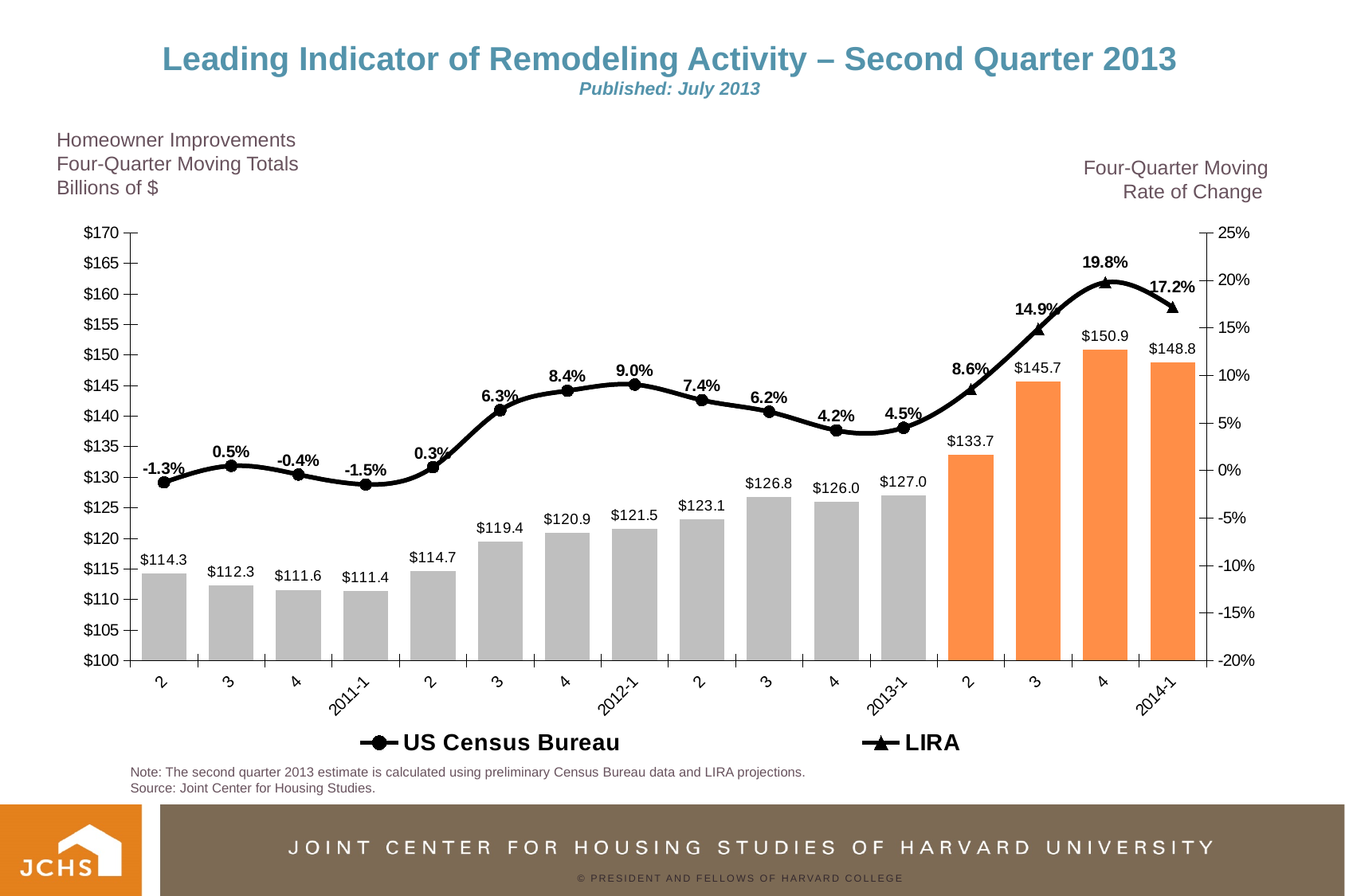
What is the four-quarter moving rate of change shown for 2011-1? -1.5% What is the highest four-quarter moving total shown on any bar? $150.9 How many quarters are shown along the x axis? 16 Do the four-quarter moving totals rise or fall from 2011-1 to 2014-1? Rise What kind of chart is this? Combination bar and line chart What is the difference between the four-quarter moving totals for 2014-1 and 2013-1? $21.8 How many series does the legend list? 2 Which has the larger four-quarter moving total, 2012-1 or 2013-1? 2013-1 Which quarter has the lowest four-quarter moving total? 2011-1 What is the highest rate of change shown on the line? 19.8% What is the four-quarter moving total for 2014-1? $148.8 What is the four-quarter moving total for 2012-1? $121.5